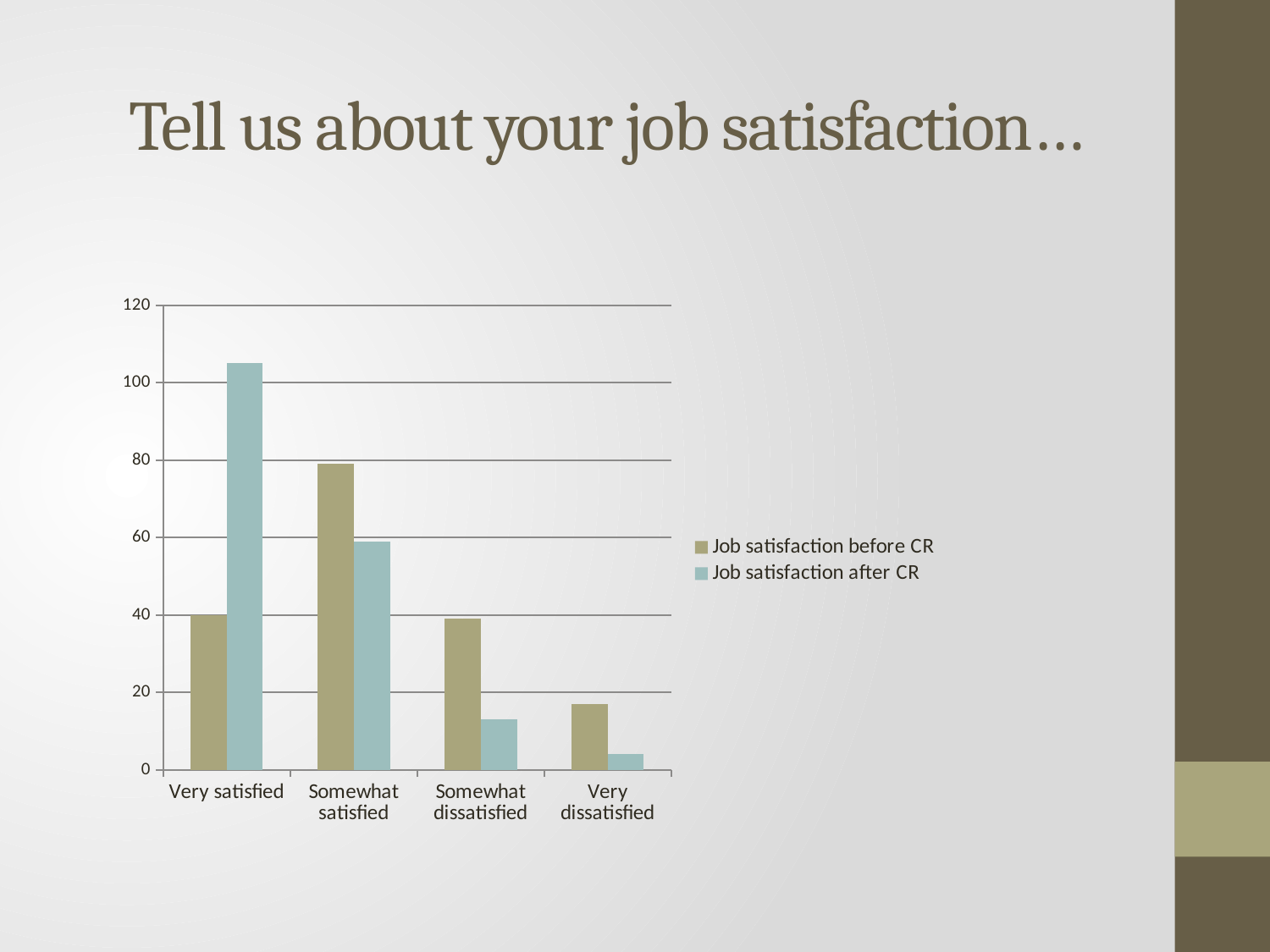
For Very satisfied, which is larger: Job satisfaction before CR or Job satisfaction after CR? Job satisfaction after CR How many series does the chart's legend list? 2 What are the two series named in the chart's legend? Job satisfaction before CR; Job satisfaction after CR Do the values for Job satisfaction after CR rise or fall moving from Very satisfied to Very dissatisfied along the x axis? Fall For Somewhat satisfied, which is larger: Job satisfaction before CR or Job satisfaction after CR? Job satisfaction before CR Which category has the highest value for Job satisfaction before CR? Somewhat satisfied Which category has the highest value for Job satisfaction after CR? Very satisfied Is the value for Job satisfaction after CR in the Very satisfied category greater or less than 100? greater Is the value for Job satisfaction after CR in the Somewhat dissatisfied category greater or less than 20? less How many categories are shown on the x axis of the chart? 4 Which category has the lowest value for Job satisfaction after CR? Very dissatisfied What kind of chart is shown on the slide? Bar chart